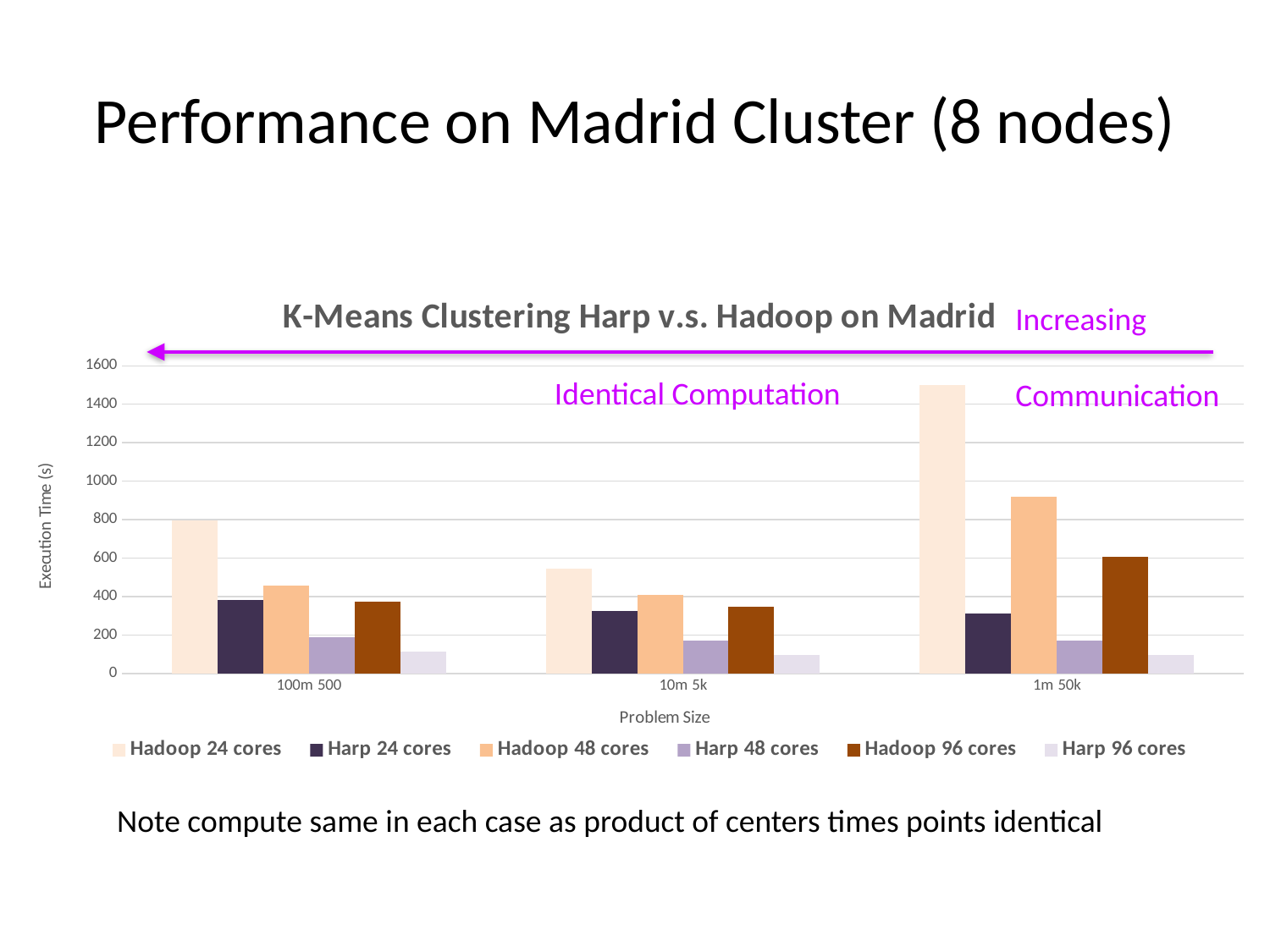
Is the value for Hadoop 96 cores at 1m 50k greater or less than 400? greater What is the title of the chart? K-Means Clustering Harp v.s. Hadoop on Madrid At 1m 50k, which series has the lowest execution time? Harp 96 cores How many problem sizes are shown on the x axis? 3 Is the value for Hadoop 24 cores at 1m 50k greater or less than 1400? greater For which problem size is the Hadoop 24 cores bar highest? 1m 50k What kind of chart is shown on the slide? bar chart How many series does the legend list? 6 Is the value for Hadoop 24 cores at 100m 500 greater or less than 1000? less At 100m 500, which is larger: Hadoop 48 cores or Harp 48 cores? Hadoop 48 cores What is the label of the y axis? Execution Time (s)